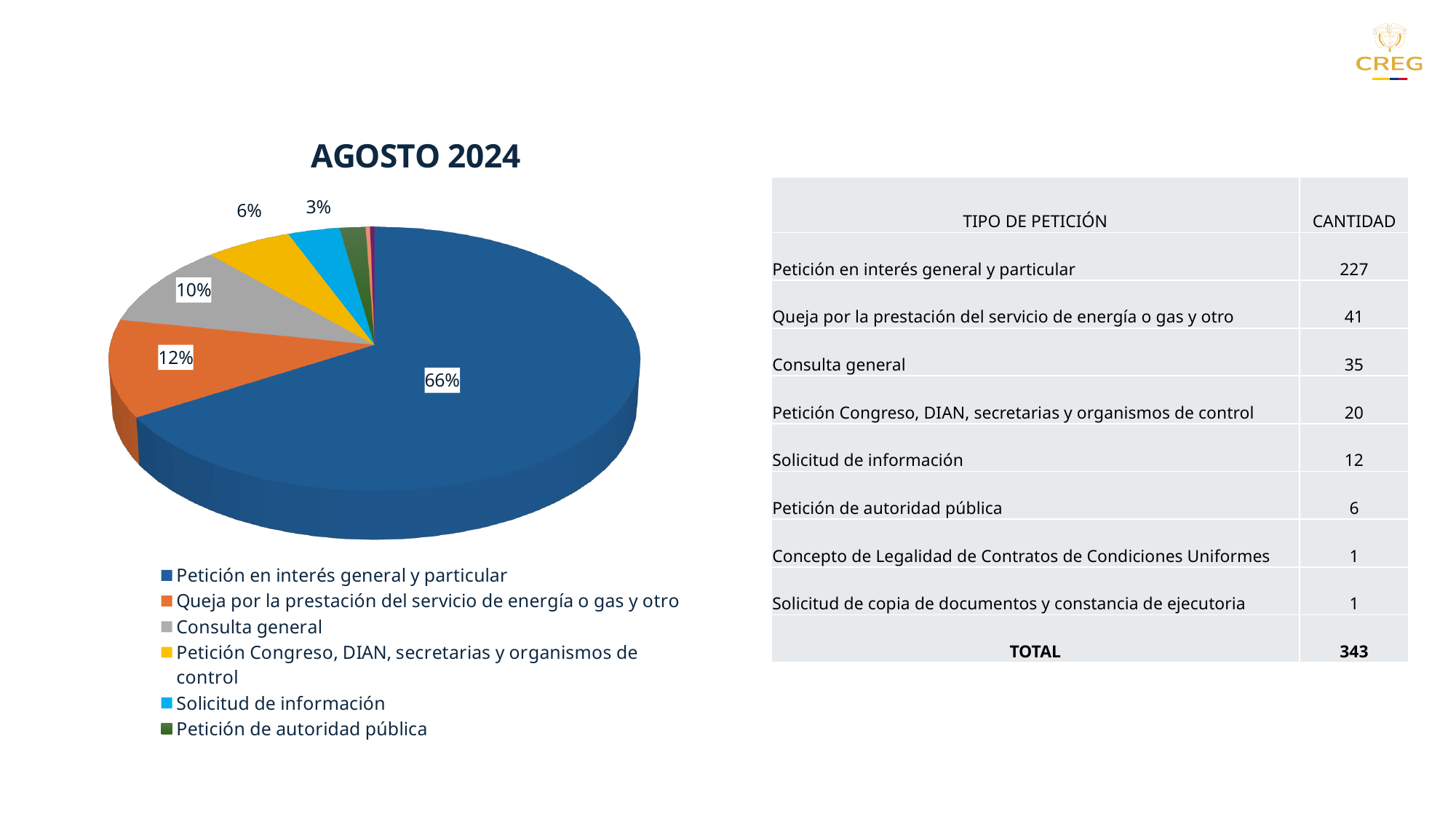
What percentage of the pie does 'Petición Congreso, DIAN, secretarias y organismos de control' represent? 6% What percentage of the pie does 'Consulta general' represent? 10% What percentage of the pie does 'Solicitud de información' represent? 3% What colour is the slice for 'Petición en interés general y particular'? blue What is the title of the chart? AGOSTO 2024 Which category has the largest slice of the pie? Petición en interés general y particular Which slice is larger: 'Consulta general' or 'Queja por la prestación del servicio de energía o gas y otro'? Queja por la prestación del servicio de energía o gas y otro What kind of chart is shown on the slide? pie chart What is the difference in percentage points between the 'Petición en interés general y particular' slice and the 'Queja por la prestación del servicio de energía o gas y otro' slice? 54% How many categories does the legend list? 6